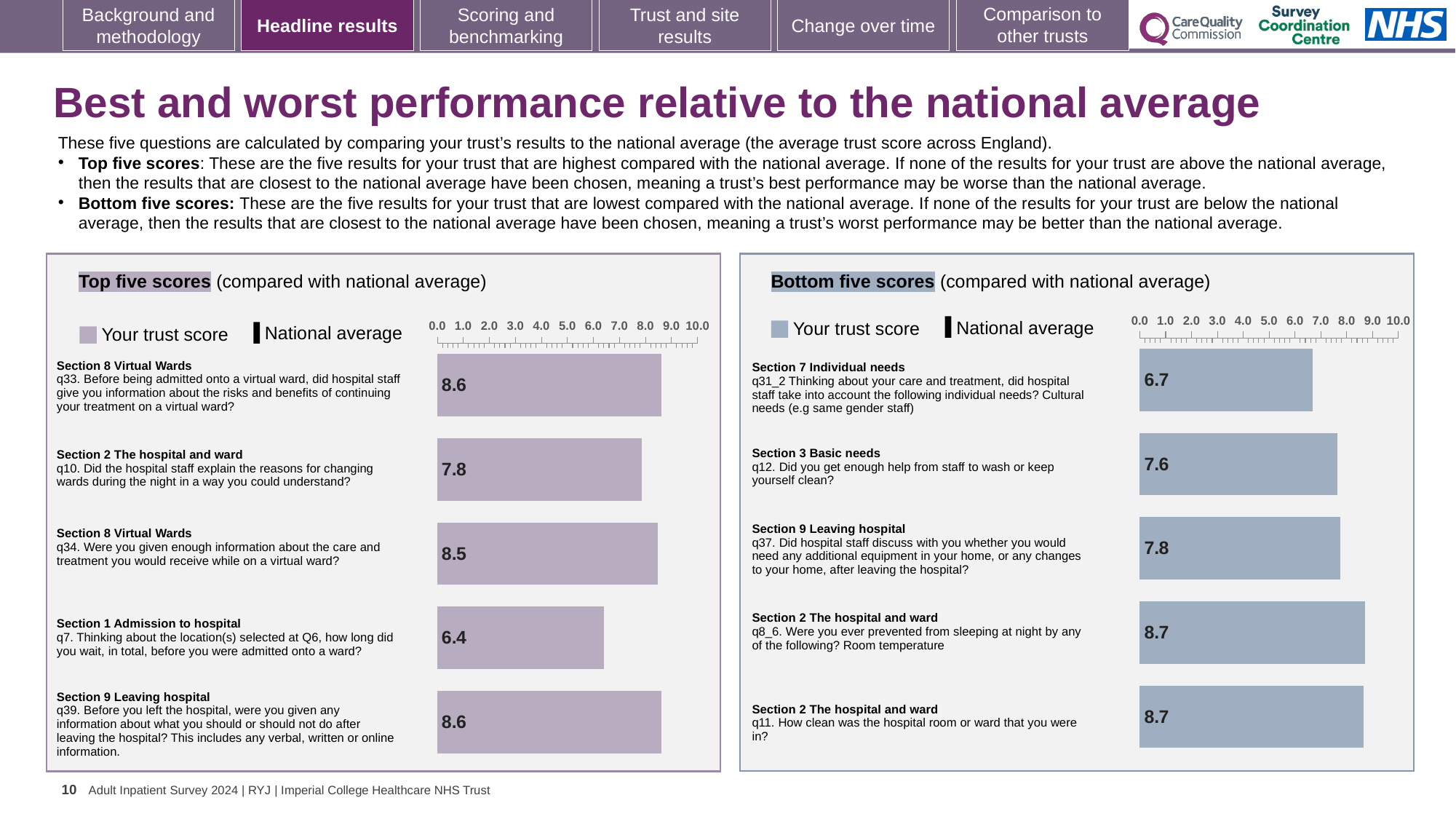
In the Top five scores chart, what is the difference between the trust scores for q33 and q7? 2.2 In the Bottom five scores chart, what is the difference between the trust scores for q11 and q31_2? 2.0 In the Top five scores chart, which question has the lowest trust score? q7 (Section 1 Admission to hospital) What kind of chart is the Bottom five scores chart? bar chart In the Top five scores chart, what is the trust score for q10 (Did the hospital staff explain the reasons for changing wards during the night)? 7.8 In the Bottom five scores chart, which has the higher trust score, q37 or q12? q37 In the Bottom five scores chart, what is the trust score for q12 (Did you get enough help from staff to wash or keep yourself clean)? 7.6 How many series does the legend of the Top five scores chart list? 2 How many bars are plotted in the Top five scores chart? 5 In the Top five scores chart, is the trust score for q34 greater or less than 8.0? greater In the Bottom five scores chart, which question has the lowest trust score? q31_2 (Section 7 Individual needs) In the Bottom five scores chart, what is the trust score for q8_6 (prevented from sleeping at night by room temperature)? 8.7